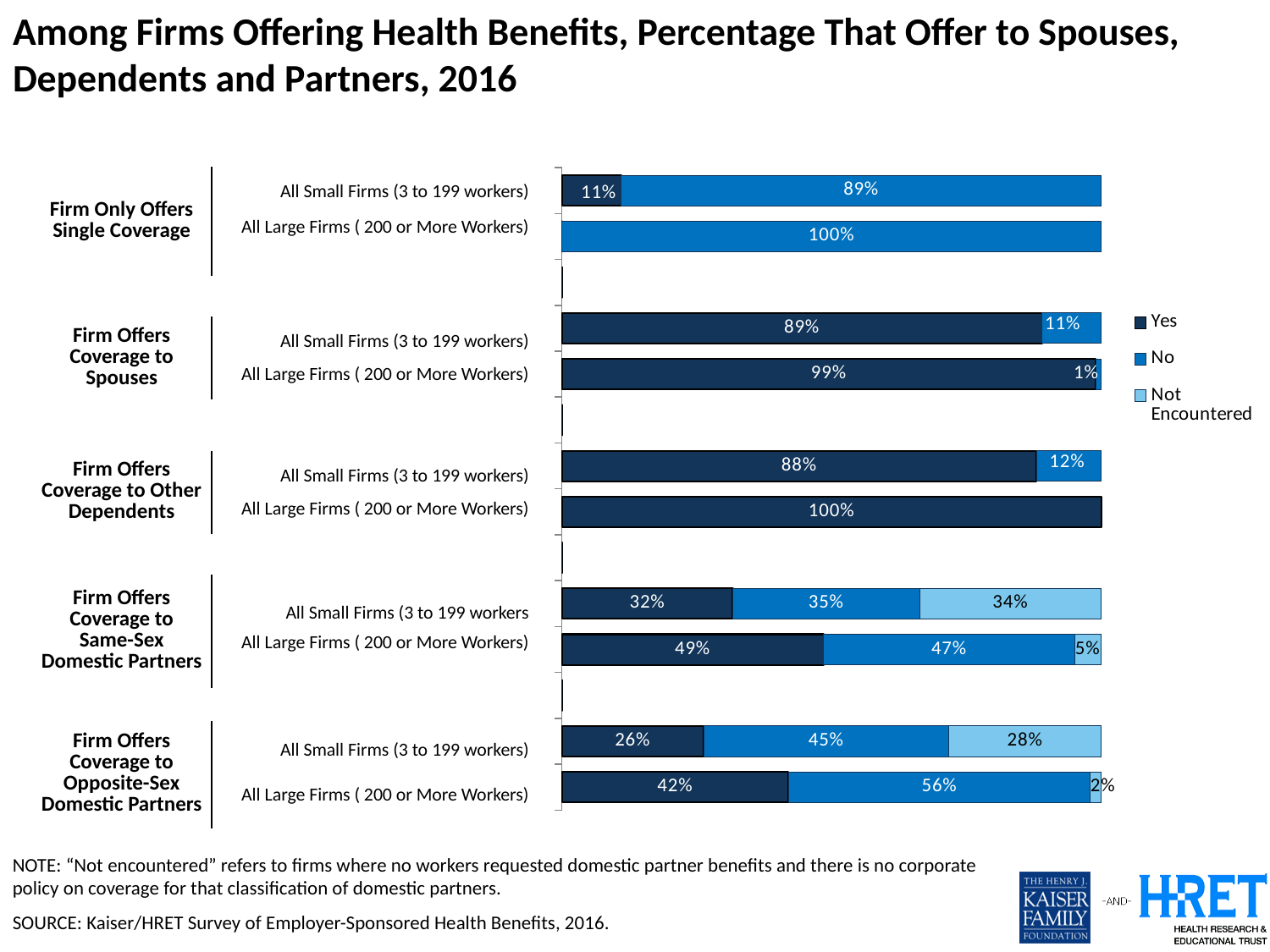
What percentage of large firms (200 or more workers) answered "No" to offering coverage to spouses? 1% What percentage of large firms (200 or more workers) answered "No" to only offering single coverage? 100% How many series does the legend list? 3 Which legend entry is shown in the lightest blue colour? Not Encountered What is the total of the "Yes" and "No" segments for small firms (3 to 199 workers) for coverage to other dependents? 100% What kind of chart is shown on the slide? Stacked bar chart For coverage to opposite-sex domestic partners, which is larger for small firms (3 to 199 workers): the "Yes" share or the "No" share? No What is the difference between the "Yes" percentages for large firms and small firms for coverage to same-sex domestic partners? 17 percentage points What percentage of small firms (3 to 199 workers) answered "Yes" to offering coverage to spouses? 89% Which firm size has the higher "Not Encountered" share for coverage to opposite-sex domestic partners? All Small Firms (3 to 199 workers) What is the "Not Encountered" percentage for small firms (3 to 199 workers) for coverage to same-sex domestic partners? 34% What percentage of large firms (200 or more workers) answered "Yes" to offering coverage to opposite-sex domestic partners? 42%